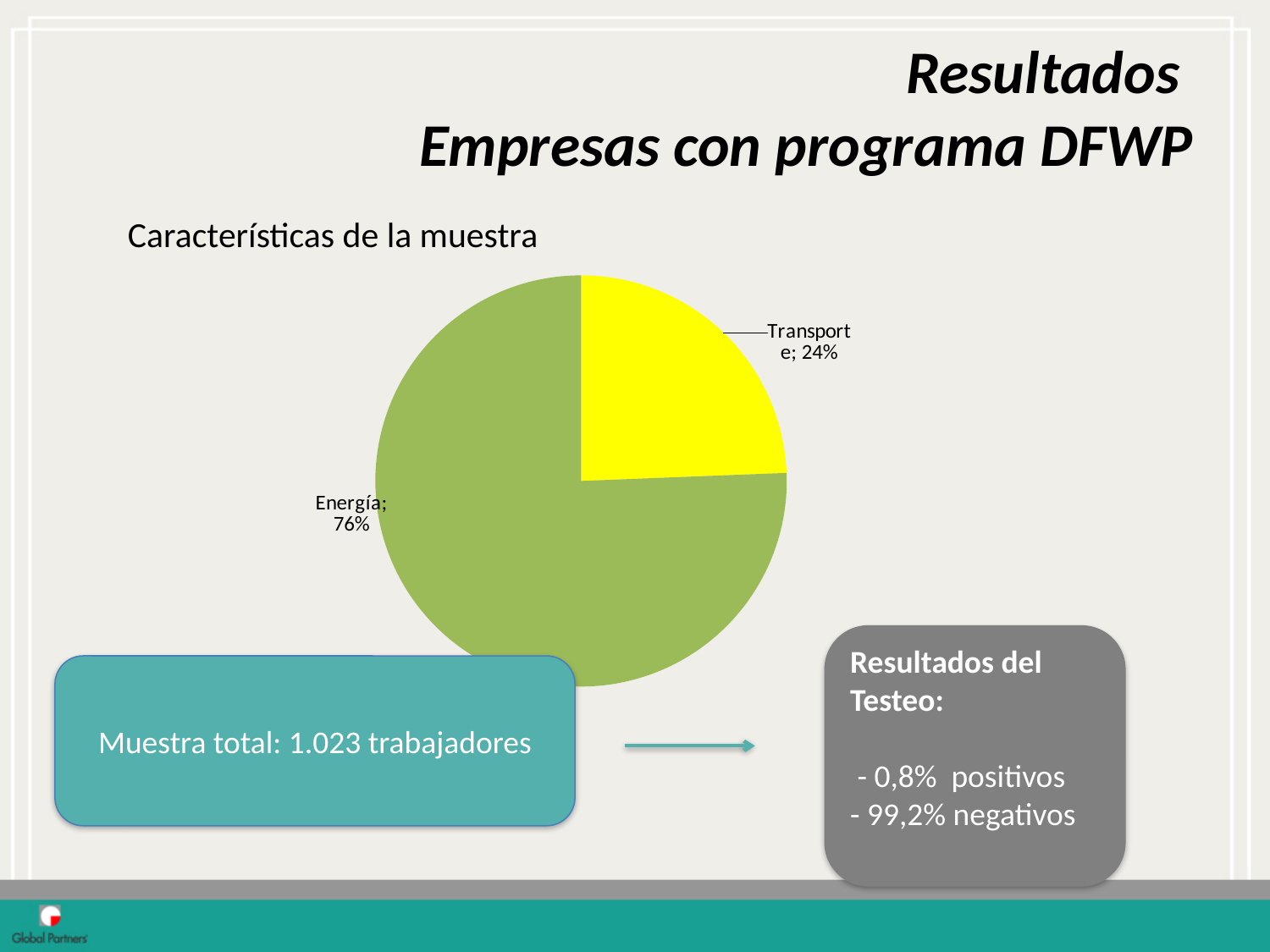
What is the total of the two slice percentages shown in the pie chart? 100% What share of the pie does Transporte represent? 24% What colour is the Transporte slice? yellow How many categories are shown in the pie chart? 2 What colour is the Energía slice? green What share of the pie does Energía represent? 76% Which slice is larger, Energía or Transporte? Energía What is the difference in percentage points between the Energía and Transporte slices? 52 Which category has the largest slice of the pie? Energía What kind of chart is shown on the slide? pie chart Which category has the smallest slice of the pie? Transporte